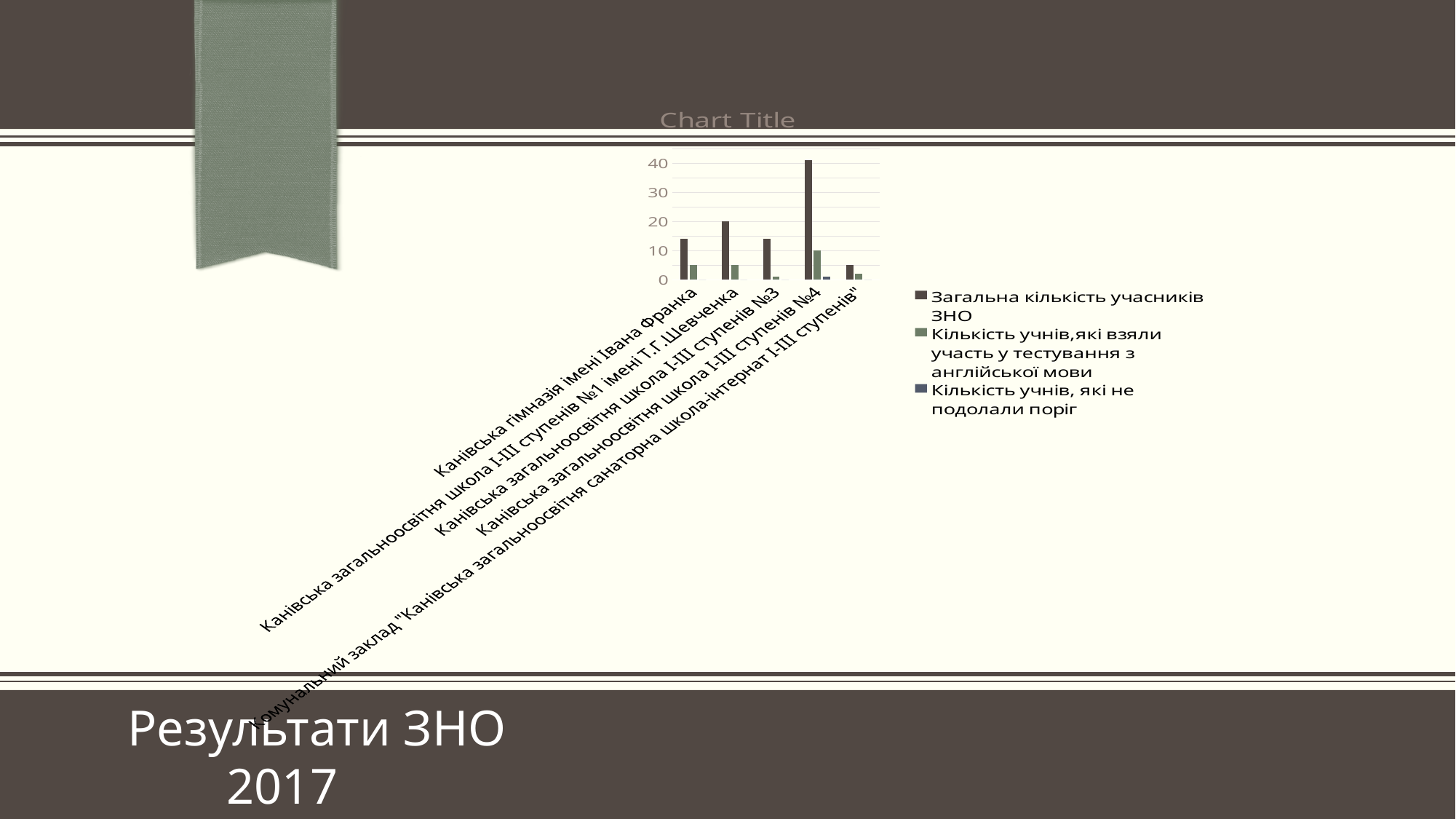
Which school has the highest value for "Кількість учнів,які взяли участь у тестування з англійської мови"? Канівська загальноосвітня школа I-III ступенів №4 What is the third series listed in the chart legend? Кількість учнів, які не подолали поріг Is the value for "Загальна кількість учасників ЗНО" at Канівська загальноосвітня школа I-III ступенів №4 greater or less than 30? greater Is the value for "Загальна кількість учасників ЗНО" at Комунальний заклад "Канівська загальноосвітня санаторна школа-інтернат I-III ступенів" greater or less than 10? less Which school has the highest value for "Загальна кількість учасників ЗНО"? Канівська загальноосвітня школа I-III ступенів №4 How many series does the chart legend list? 3 What kind of chart is shown on the slide? bar chart Which has the larger value for "Загальна кількість учасників ЗНО": Канівська загальноосвітня школа I-III ступенів №1 імені Т.Г.Шевченка or Канівська загальноосвітня школа I-III ступенів №3? Канівська загальноосвітня школа I-III ступенів №1 імені Т.Г.Шевченка Is the value for "Загальна кількість учасників ЗНО" at Канівська гімназія імені Івана Франка greater or less than 20? less What is the title shown above the chart? Chart Title Which school has the lowest value for "Загальна кількість учасників ЗНО"? Комунальний заклад "Канівська загальноосвітня санаторна школа-інтернат I-III ступенів" How many schools (categories) are shown on the x axis of the chart? 5